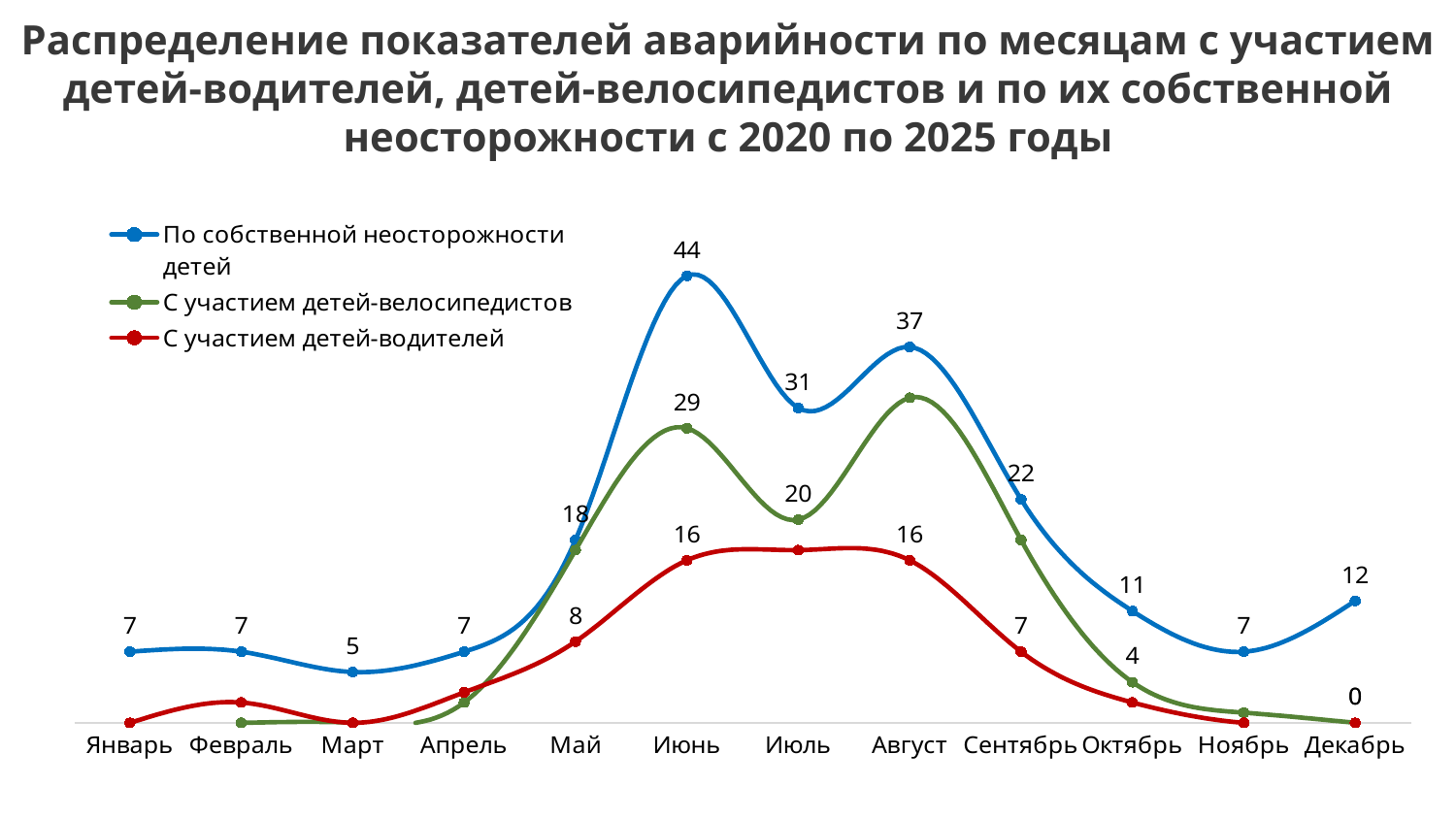
What is the value for Июнь in the series 'По собственной неосторожности детей'? 44 In which month is the series 'По собственной неосторожности детей' highest? Июнь How many months are shown on the x axis? 12 What type of chart is shown on the slide? Line chart What is the value for Июнь in the series 'С участием детей-велосипедистов'? 29 How many series does the legend list? 3 What is the value for Август in the series 'По собственной неосторожности детей'? 37 What is the difference between the Июнь and Июль values in the series 'По собственной неосторожности детей'? 13 What is the value for Май in the series 'С участием детей-водителей'? 8 Does the series 'По собственной неосторожности детей' rise or fall from Апрель to Июнь? Rise In Июнь, which series has the larger value: 'По собственной неосторожности детей' or 'С участием детей-велосипедистов'? По собственной неосторожности детей In which month is the series 'По собственной неосторожности детей' lowest? Март